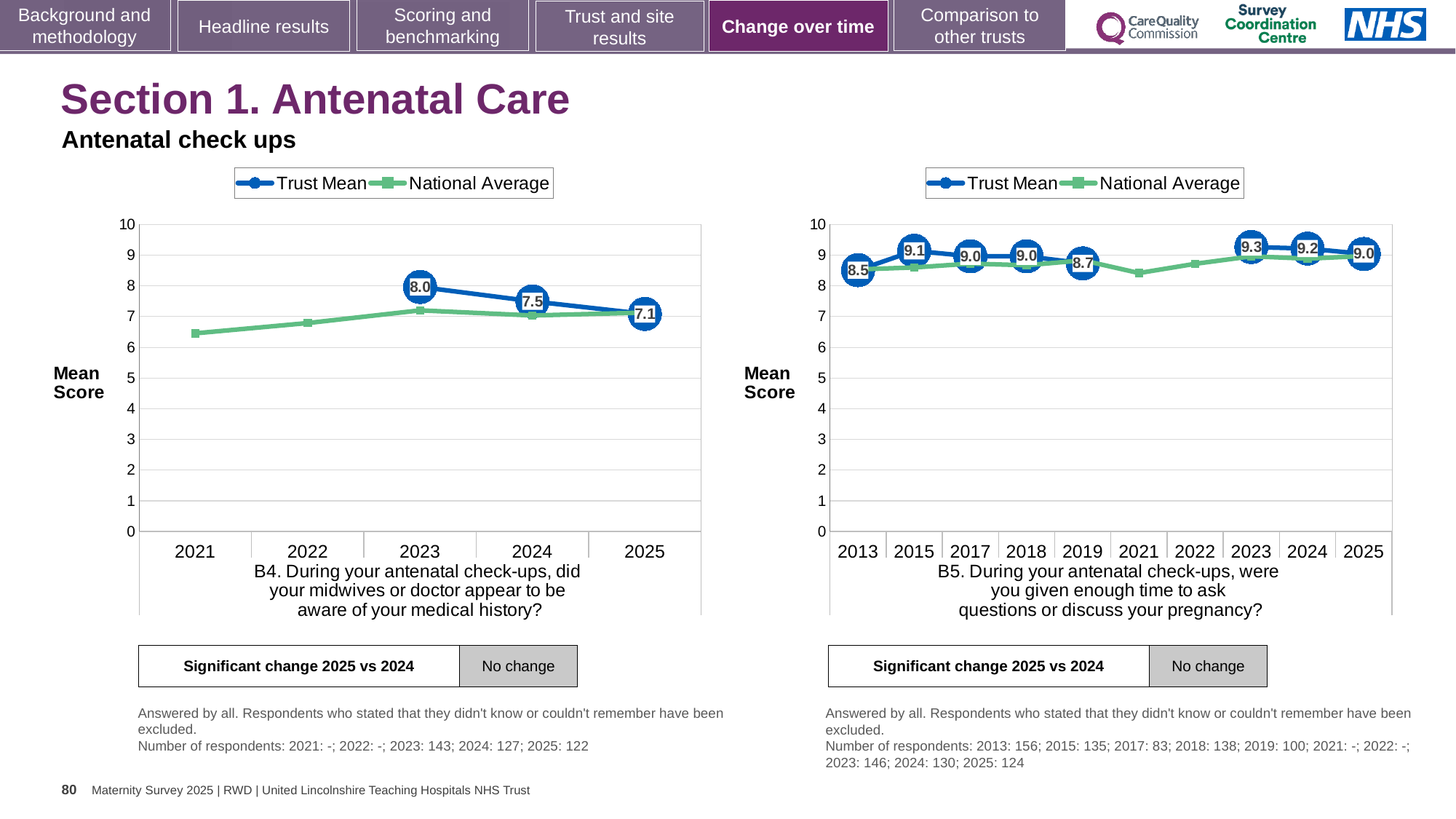
In the right chart (B5), which year has the lowest Trust Mean? 2013 In the right chart (B5), how many years are shown on the x axis? 10 In the left chart (B4), does the Trust Mean rise or fall from 2023 to 2025? fall In the right chart (B5), what is the difference between the Trust Mean for 2023 and 2025? 0.3 In the left chart (B4), what is the Trust Mean for 2025? 7.1 In the right chart (B5), what is the Trust Mean for 2013? 8.5 In the left chart (B4), what is the Trust Mean for 2023? 8.0 In the left chart (B4), how many series does the legend list? 2 In the left chart (B4), by how much did the Trust Mean fall from 2023 to 2025? 0.9 In the right chart (B5), which year has the highest Trust Mean? 2023 What type of chart is the right chart (B5)? line chart In the left chart (B4), is the National Average for 2021 greater or less than 7? less